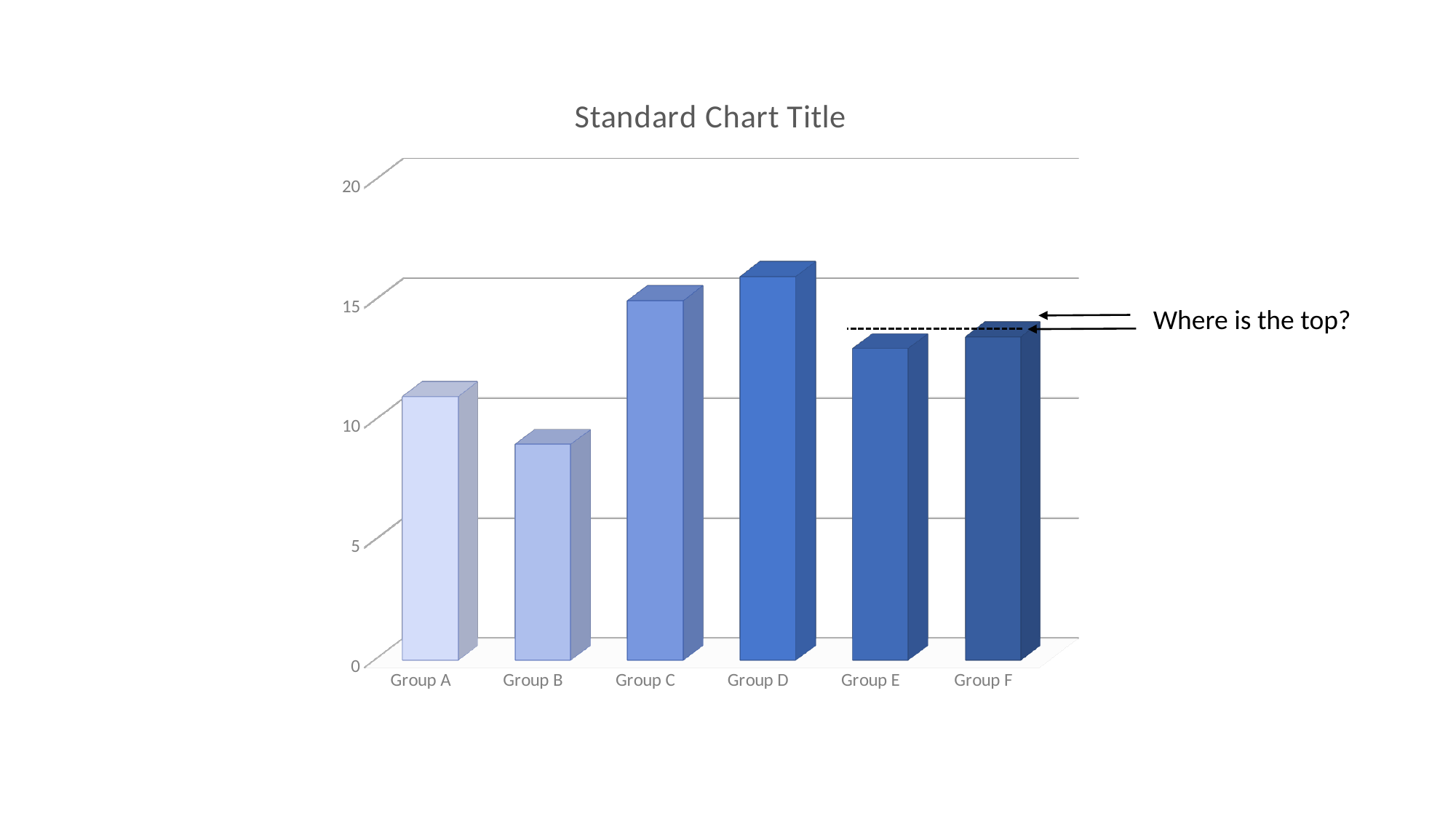
Which is larger, the value for Group C or the value for Group E? Group C Is the value for Group B greater or less than 10? less Is the value for Group B greater or less than 5? greater What kind of chart is shown on the slide? bar chart Which is larger, the value for Group A or the value for Group B? Group A Which group has the lowest bar? Group B Is the value for Group C greater or less than 10? greater Which group has the highest bar? Group D How many groups are plotted on the x axis? 6 What is the title of the chart? Standard Chart Title